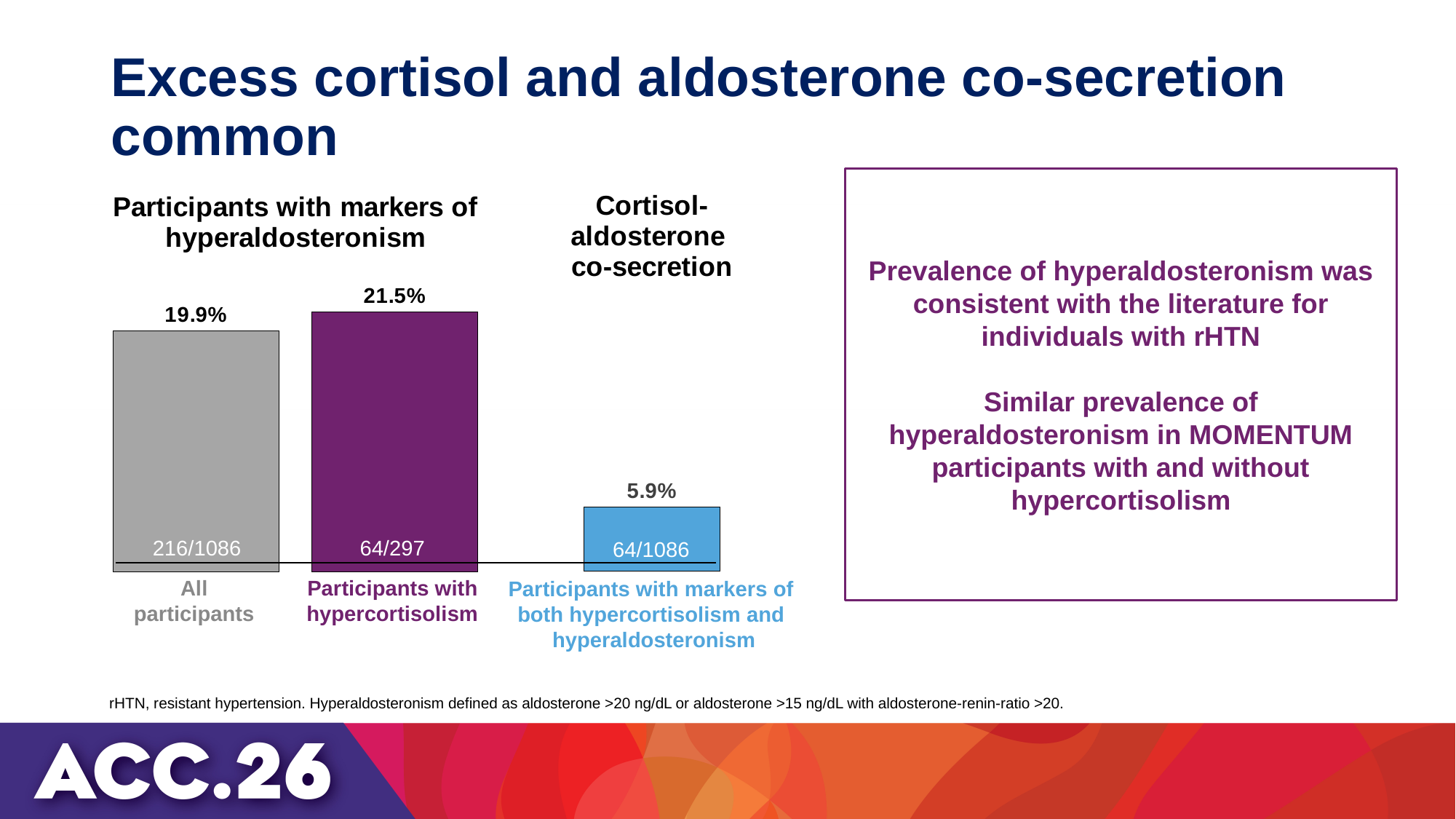
What percentage is shown for Participants with hypercortisolism? 21.5% What is the difference in percentage points between All participants and Participants with markers of both hypercortisolism and hyperaldosteronism? 14.0 Which bar has the lowest percentage? Participants with markers of both hypercortisolism and hyperaldosteronism What fraction is printed inside the bar for All participants? 216/1086 What kind of chart is shown on the slide? Bar chart What percentage is shown for Participants with markers of both hypercortisolism and hyperaldosteronism? 5.9% Which is larger, the percentage for All participants or for Participants with markers of both hypercortisolism and hyperaldosteronism? All participants Which bar has the highest percentage? Participants with hypercortisolism How many bars are shown in the chart? 3 What percentage is shown for All participants? 19.9% What is the difference in percentage points between Participants with hypercortisolism and All participants? 1.6 What fraction is printed inside the bar for Participants with hypercortisolism? 64/297